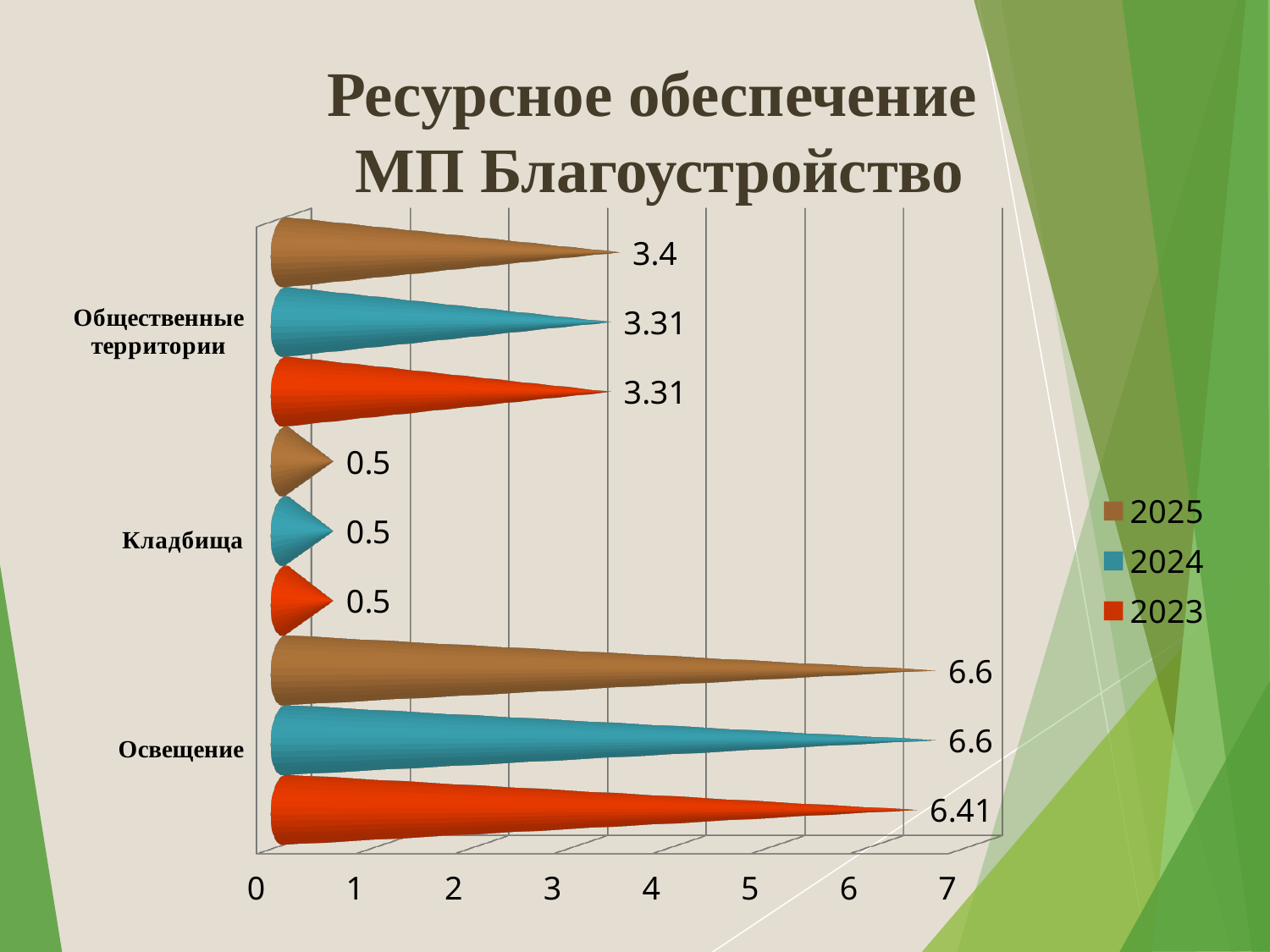
Which is larger: the 2025 value for Освещение or the 2025 value for Общественные территории? Освещение What is the difference between the 2025 and 2024 values for Общественные территории? 0.09 What is the value for Освещение in the 2023 series? 6.41 What is the difference between the 2025 and 2023 values for Освещение? 0.19 Which category has the lowest value in the 2023 series? Кладбища Which category has the highest value in the 2025 series? Освещение What type of chart is shown on the slide? Bar chart How many series does the legend list? 3 How many categories are shown on the chart? 3 What is the value for Кладбища in the 2024 series? 0.5 What is the value for Общественные территории in the 2024 series? 3.31 What is the value for Общественные территории in the 2025 series? 3.4